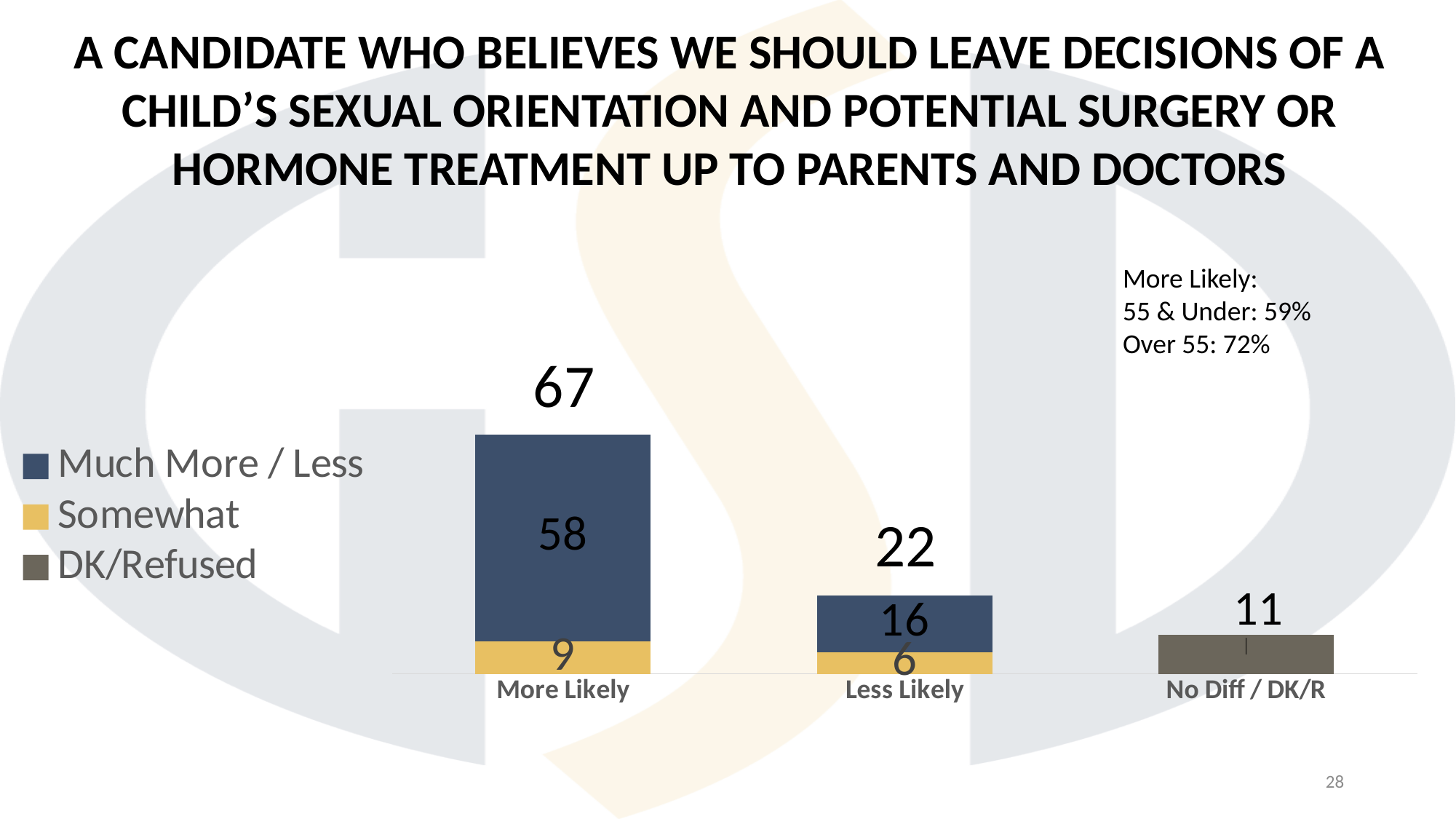
What kind of chart is shown on the slide? Stacked bar chart What is the total of the stacked More Likely bar? 67 What is the value of the No Diff / DK/R bar? 11 How many categories are shown on the x axis? 3 What is the difference between the Much More / Less values for More Likely and Less Likely? 42 What is the Much More / Less value for the More Likely bar? 58 What is the total of the stacked Less Likely bar? 22 Which category has the highest total? More Likely How many series does the legend list? 3 Which is larger, the Somewhat value for More Likely or the Somewhat value for Less Likely? More Likely What is the Somewhat value for the Less Likely bar? 6 Which category has the lowest total? No Diff / DK/R